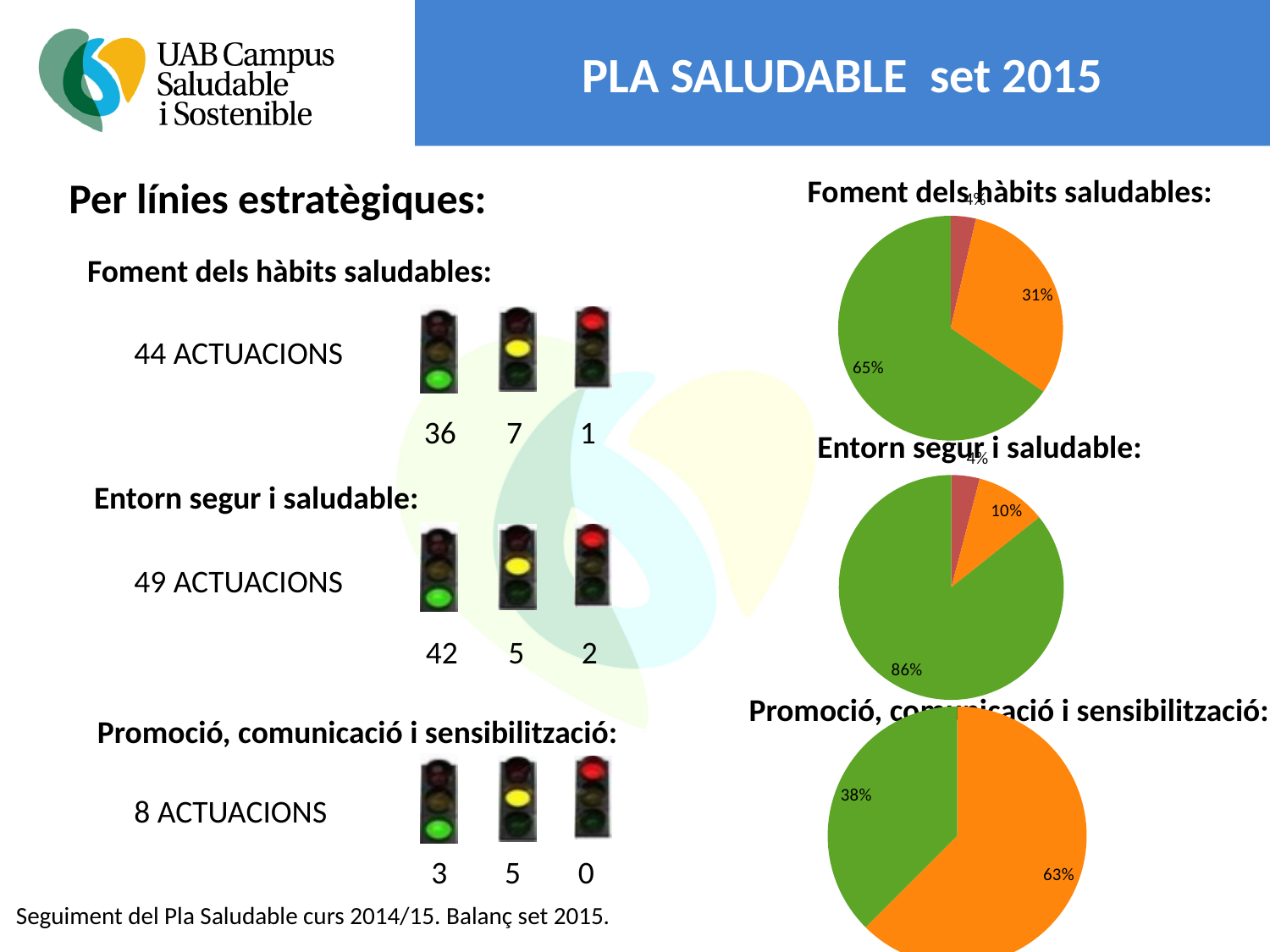
In the 'Foment dels hàbits saludables' pie chart, which colour slice is the largest? green In the 'Entorn segur i saludable' pie chart, what percentage does the green slice show? 86% In the 'Entorn segur i saludable' pie chart, which colour slice is the smallest? red In the 'Promoció, comunicació i sensibilització' pie chart, what percentage does the green slice show? 38% What kind of chart is used for 'Foment dels hàbits saludables' on the right of the slide? pie chart In the 'Promoció, comunicació i sensibilització' pie chart, which is larger, the green slice or the orange slice? orange In the 'Promoció, comunicació i sensibilització' pie chart, what percentage does the orange slice show? 63% In the 'Foment dels hàbits saludables' pie chart, what percentage does the green slice show? 65% In the 'Entorn segur i saludable' pie chart, what percentage does the orange slice show? 10% In the 'Foment dels hàbits saludables' pie chart, what percentage does the orange slice show? 31% How many pie charts are shown on the slide? 3 In the 'Foment dels hàbits saludables' pie chart, what is the difference between the green slice and the orange slice? 34%